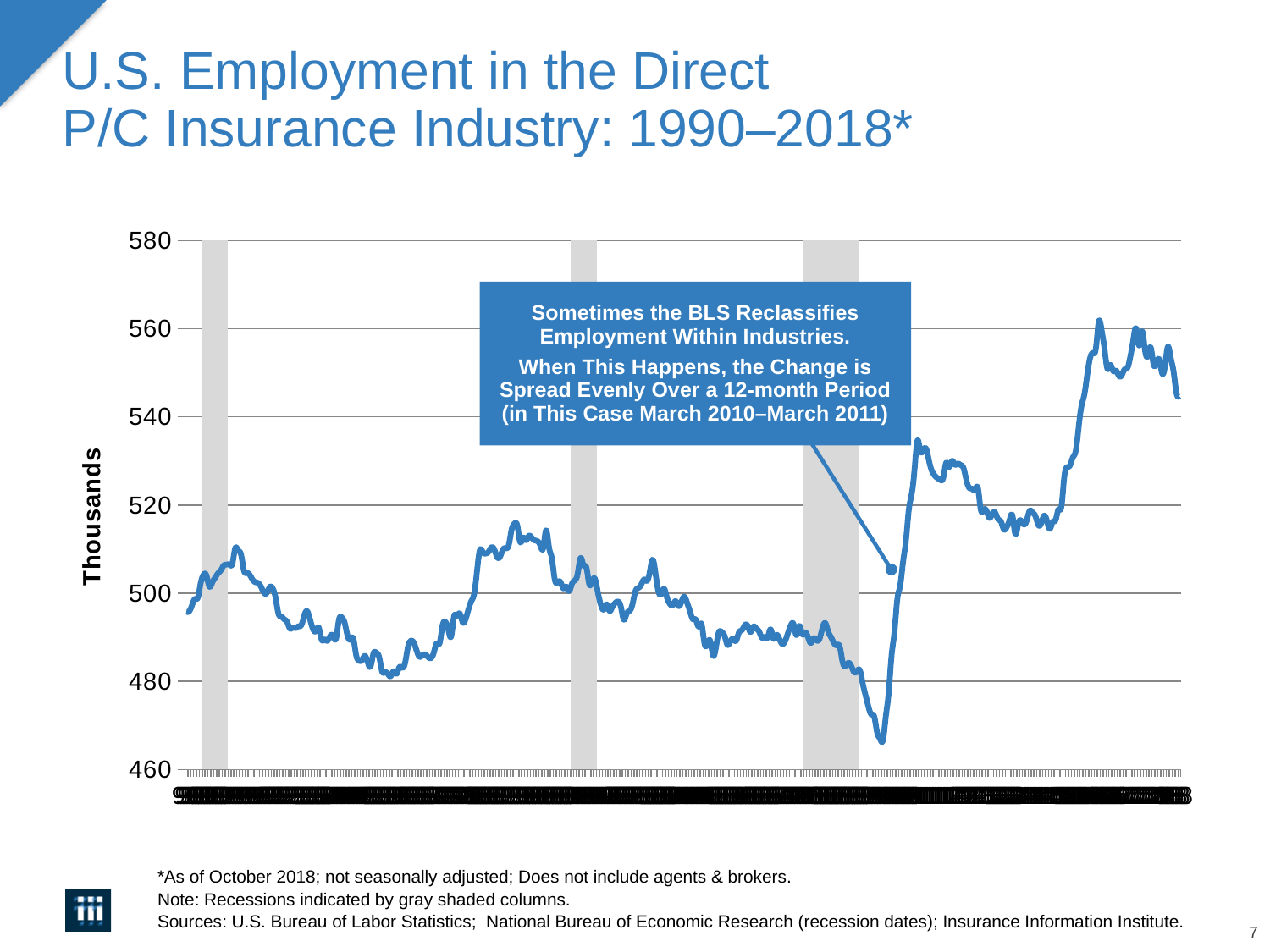
Is the lowest point of the line on the chart greater or less than 480? less What is the title of the chart on the slide? U.S. Employment in the Direct P/C Insurance Industry: 1990–2018* Is the value at the right-hand end of the line greater or less than 540? greater What is the highest value shown on the vertical axis of the chart? 580 Is the value at the left-hand start of the line greater or less than 500? less What is the label on the vertical axis of the chart? Thousands What kind of chart is shown on the slide? line chart Overall, does the line end higher or lower than where it starts on the left? higher